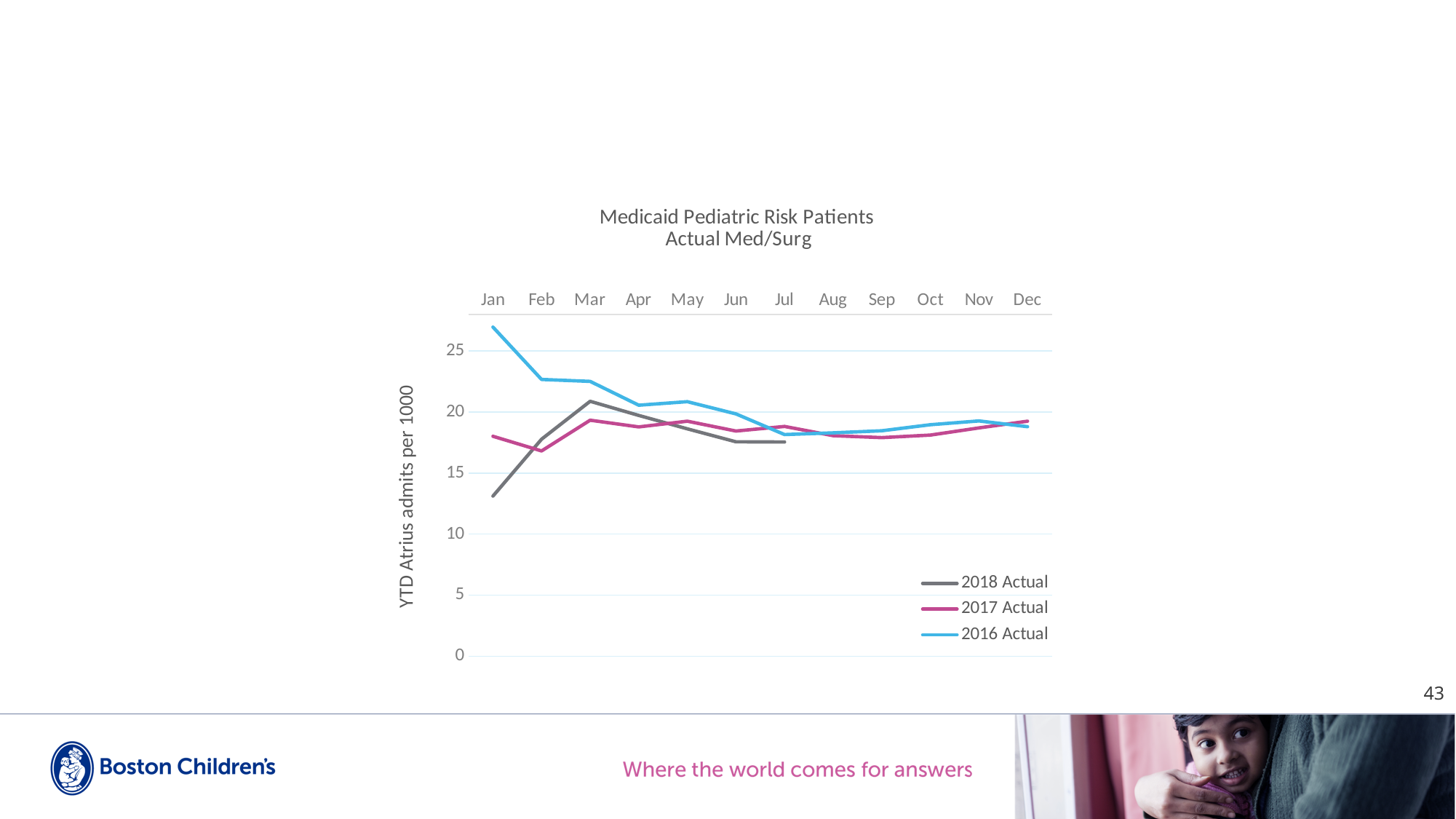
How many months are shown along the x axis? 12 Which series has the lowest value in Jan? 2018 Actual Is the value for 2016 Actual in Jan greater or less than 25? greater Is the value for 2018 Actual in Mar greater or less than 20? greater Which series has the highest value in Jan? 2016 Actual How many series does the legend list? 3 Does the 2016 Actual line rise or fall from Jan to Jun? fall What kind of chart is shown on the slide? line chart What is the label on the y axis? YTD Atrius admits per 1000 Is the value for 2017 Actual in Feb greater or less than 20? less In which month does 2016 Actual reach its highest value? Jan